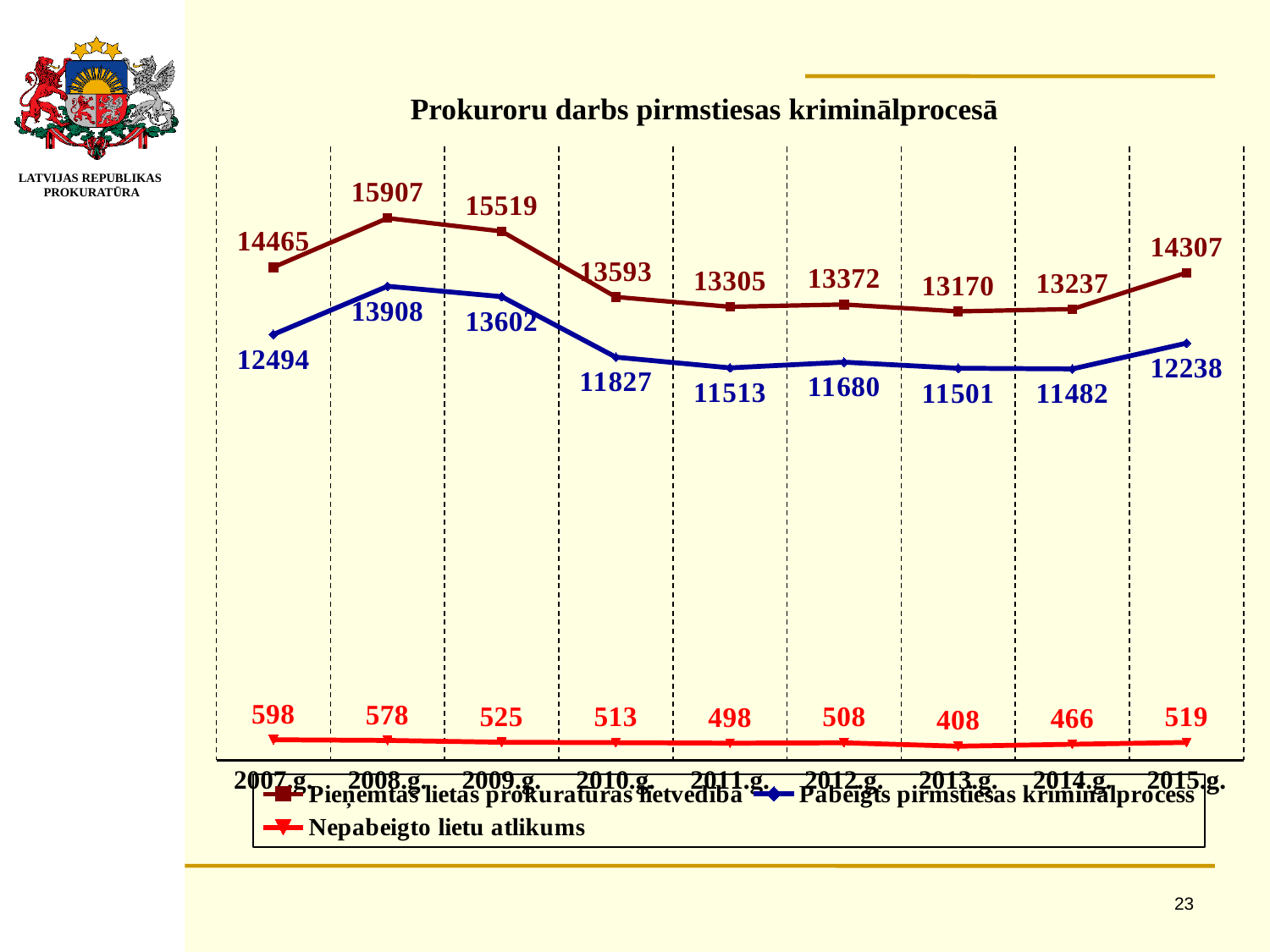
What is the value of 'Pabeigts pirmstiesas kriminālprocess' in 2014.g.? 11482 What type of chart is shown on the slide? line chart What is the title of the chart? Prokuroru darbs pirmstiesas kriminālprocesā How many series does the legend list? 3 What is the value of 'Nepabeigto lietu atlikums' in 2013.g.? 408 In which year is 'Pieņemtas lietas prokuratūras lietvedībā' highest? 2008.g. How many years are shown on the x axis? 9 In which year is 'Nepabeigto lietu atlikums' lowest? 2013.g. Which is larger: 'Pabeigts pirmstiesas kriminālprocess' in 2009.g. or in 2010.g.? 2009.g. What is the difference between 'Pieņemtas lietas prokuratūras lietvedībā' and 'Pabeigts pirmstiesas kriminālprocess' in 2015.g.? 2069 What is the value of 'Pieņemtas lietas prokuratūras lietvedībā' in 2008.g.? 15907 Does 'Pieņemtas lietas prokuratūras lietvedībā' rise or fall from 2008.g. to 2011.g.? fall